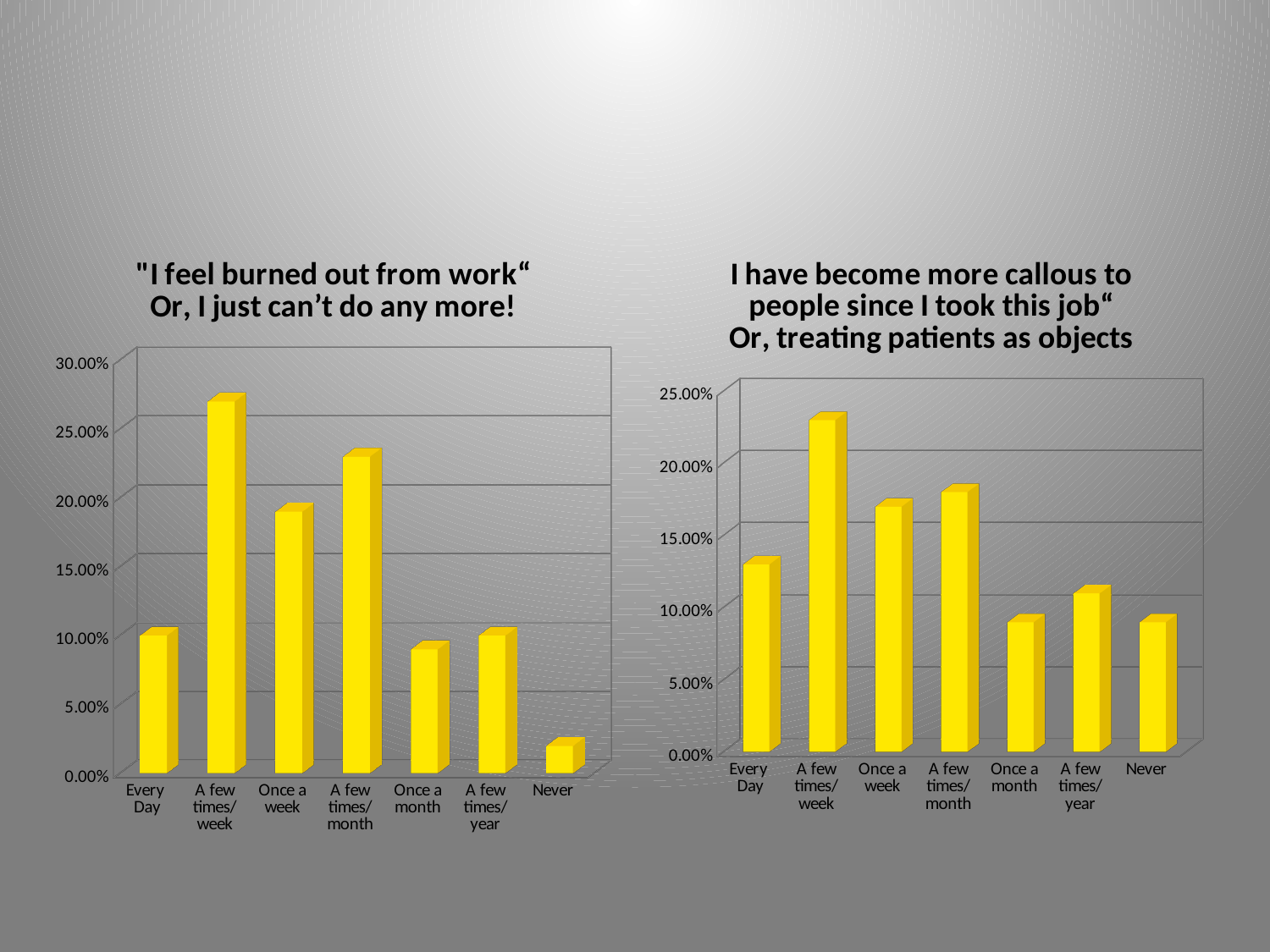
In the chart titled "I have become more callous to people since I took this job", is the value for A few times/week greater or less than 25.00%? less In the chart titled "I feel burned out from work", which category has the lowest value? Never How many charts are shown on the slide? 2 What kind of chart is the one on the right of the slide? Bar chart In the chart titled "I feel burned out from work", how many categories are shown on the x axis? 7 In the chart titled "I have become more callous to people since I took this job", which is larger: Every Day or Once a month? Every Day In the chart titled "I have become more callous to people since I took this job", is the value for Every Day greater or less than 10.00%? greater In the chart titled "I have become more callous to people since I took this job", which category has the highest value? A few times/week In the chart titled "I feel burned out from work", which category has the highest value? A few times/week In the chart titled "I feel burned out from work", is the value for A few times/week greater or less than 25.00%? greater In the chart titled "I feel burned out from work", which is larger: Once a week or A few times/month? A few times/month